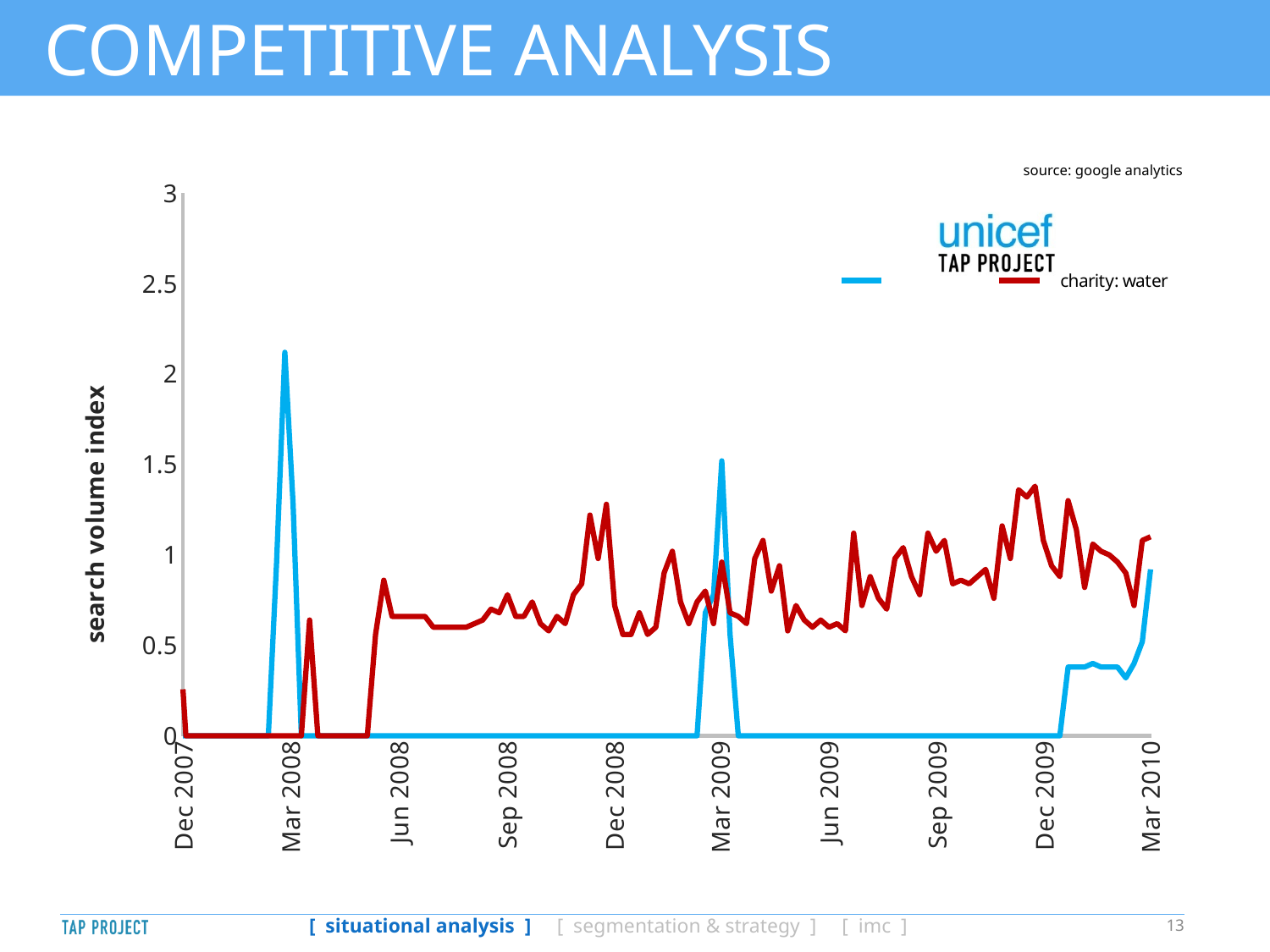
Does the unicef TAP PROJECT line rise or fall between Dec 2009 and Mar 2010? rise Is the value of the unicef TAP PROJECT line at Mar 2010 greater or less than 0.5? greater Is the peak value of the unicef TAP PROJECT line near Mar 2008 greater or less than 2? greater Which series stays at zero for most of the period shown? unicef TAP PROJECT Is the value of the unicef TAP PROJECT line at Sep 2008 greater or less than 0.5? less What source is cited for the chart? google analytics Which series reaches the higher peak value over the whole period? unicef TAP PROJECT What is the label on the y axis? search volume index How many date labels are shown on the x axis? 10 What kind of chart is shown on the slide? line chart How many series does the legend list? 2